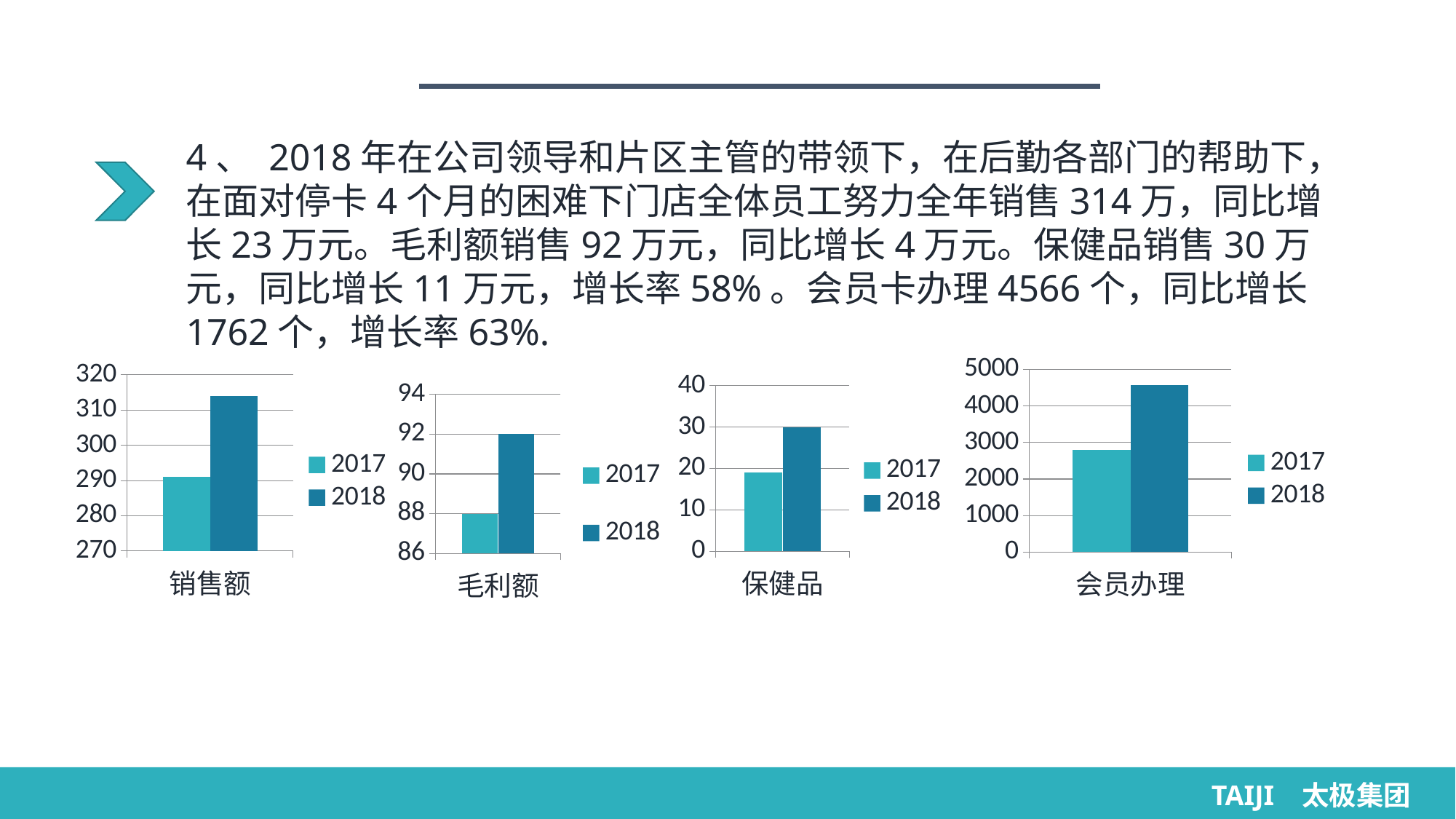
In the 销售额 chart, is the value for 2018 greater or less than 310? greater In the 保健品 chart, what is the value for 2018? 30 In the 毛利额 chart, what is the value for 2017? 88 In the 保健品 chart, is the value for 2017 greater or less than 20? less In the 会员办理 chart, is the value for 2017 greater or less than 3000? less What kind of chart is the 保健品 chart? Bar chart In the 会员办理 chart, which series has the higher value, 2017 or 2018? 2018 In the 毛利额 chart, what is the value for 2018? 92 In the 毛利额 chart, what is the difference between the 2018 and 2017 values? 4 How many series does the legend of the 销售额 chart list? 2